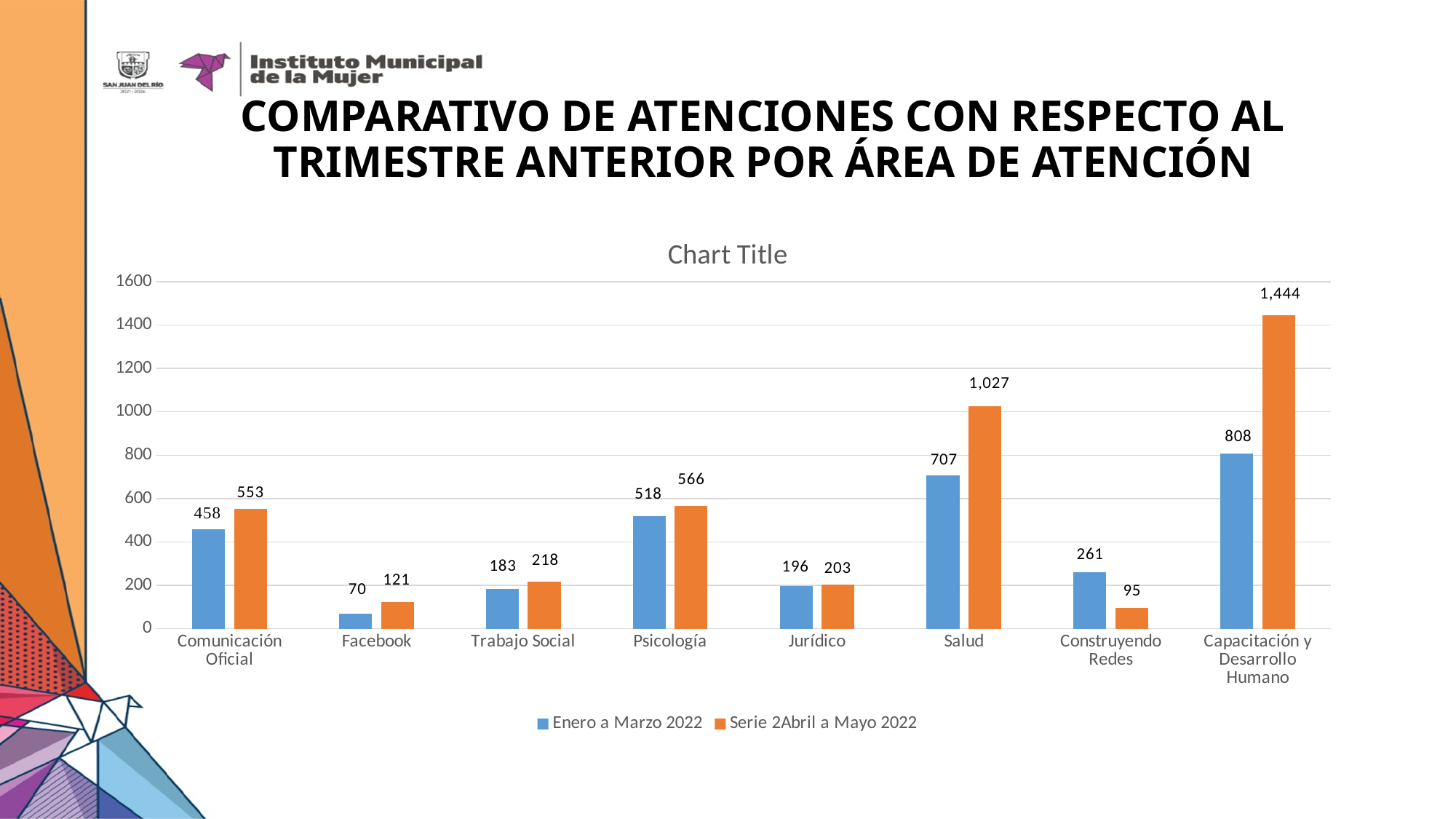
How many series does the legend list? 2 What is the title shown above the chart? Chart Title Is the value for Psicología in the Enero a Marzo 2022 series greater or less than 400? greater What kind of chart is shown on the slide? bar chart How many categories are shown on the x axis? 8 What is the value for Salud in the Enero a Marzo 2022 series? 707 Which category has the highest value in the Serie 2Abril a Mayo 2022 series? Capacitación y Desarrollo Humano What is the value for Facebook in the Enero a Marzo 2022 series? 70 Which category has the lowest value in the Enero a Marzo 2022 series? Facebook What is the difference between the Serie 2Abril a Mayo 2022 and Enero a Marzo 2022 values for Salud? 320 What is the value for Capacitación y Desarrollo Humano in the Serie 2Abril a Mayo 2022 series? 1,444 For Construyendo Redes, which series has the larger value, Enero a Marzo 2022 or Serie 2Abril a Mayo 2022? Enero a Marzo 2022